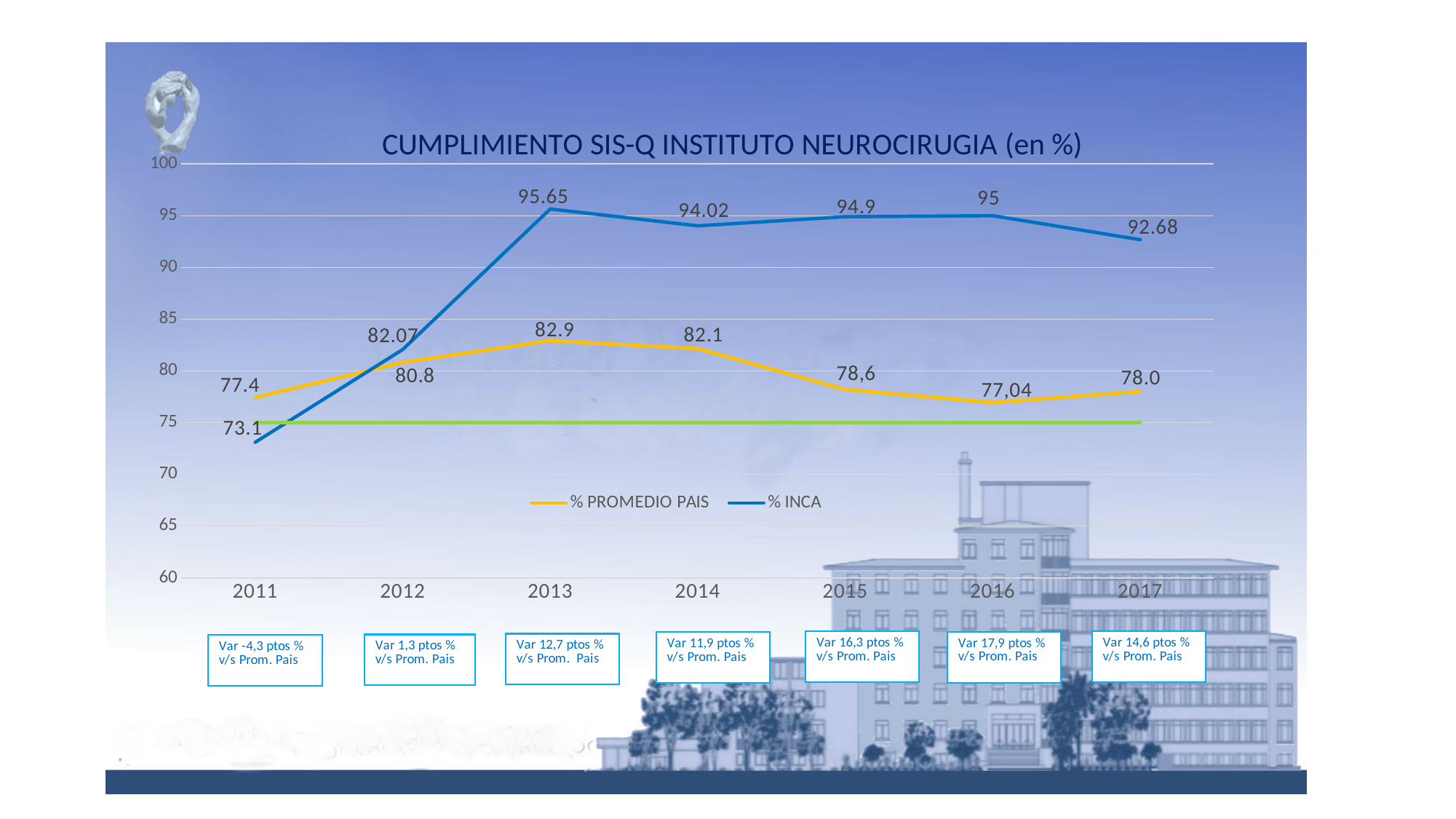
Which is larger in 2012, % INCA or % PROMEDIO PAIS? % INCA In which year is the % INCA value lowest? 2011 In which year is the % INCA value highest? 2013 What is the % PROMEDIO PAIS value for 2016? 77,04 What kind of chart is shown on the slide? line chart Is the % INCA value for 2014 greater or less than 90? greater What is the % INCA value for 2017? 92.68 What is the % PROMEDIO PAIS value for 2011? 77.4 What is the % INCA value for 2013? 95.65 How many years are shown on the x axis? 7 In which year is the % PROMEDIO PAIS value highest? 2013 What is the difference between % PROMEDIO PAIS and % INCA in 2011? 4.3